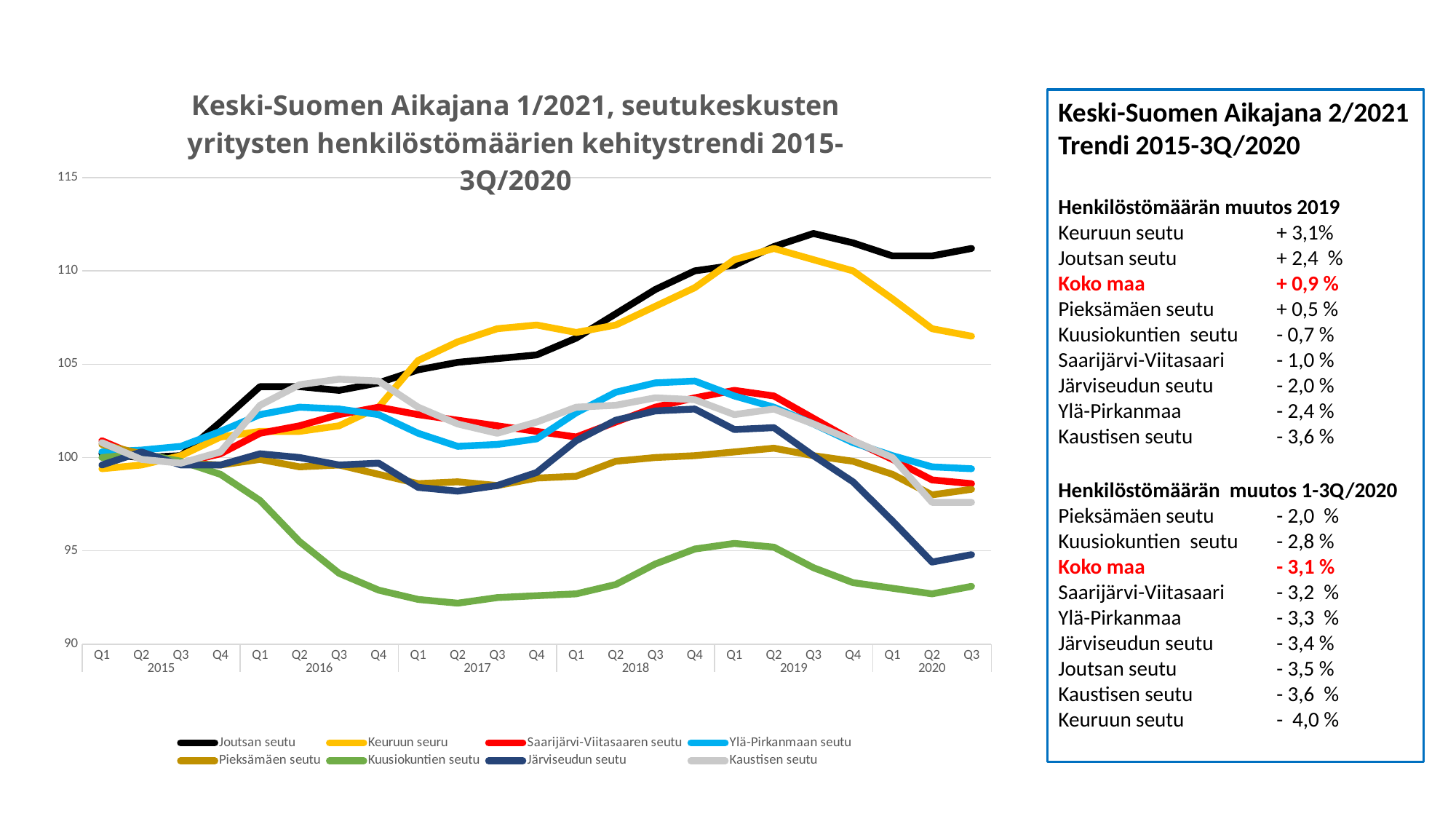
Is the value for Joutsan seutu at Q3 2020 greater or less than 110? greater What colour is the Joutsan seutu line in the chart? black How many series does the chart's legend list? 8 Which series has the highest value at Q3 2020? Joutsan seutu Does the Kuusiokuntien seutu line rise or fall from Q1 2015 to Q2 2017? fall At Q3 2020, which is larger: the value for Joutsan seutu or the value for Kuusiokuntien seutu? Joutsan seutu How many quarterly points are plotted along the x axis of the chart? 23 Is the value for Keuruun seutu at Q3 2020 greater or less than 105? greater Is the value for Järviseudun seutu at Q2 2020 greater or less than 95? less Which series has the lowest value at Q3 2020? Kuusiokuntien seutu What kind of chart is shown on the slide? line chart